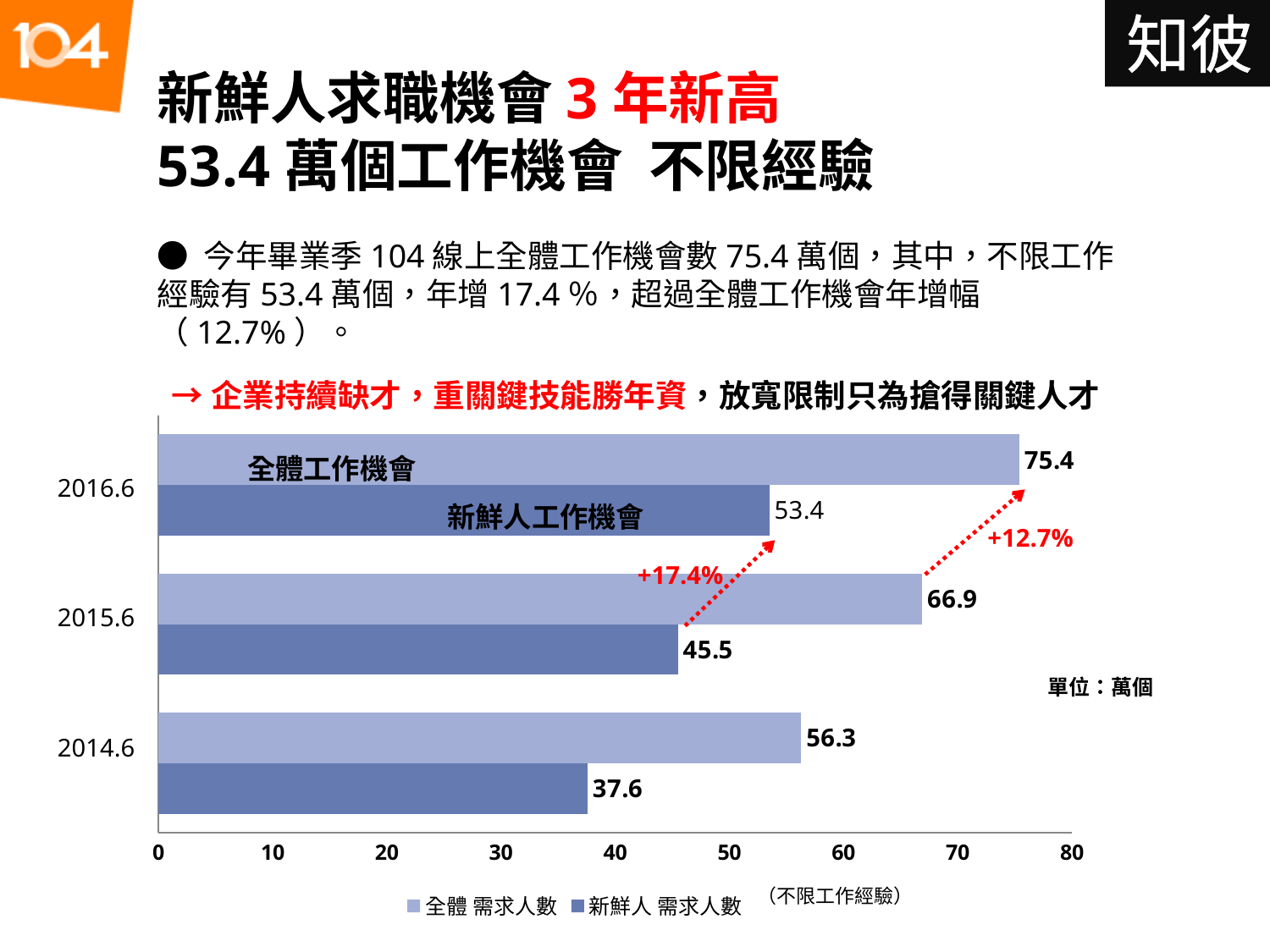
What is the value of 全體 需求人數 for 2016.6? 75.4 What kind of chart is shown on the slide? bar chart Which is larger: 新鮮人 需求人數 in 2016.6 or 全體 需求人數 in 2014.6? 全體 需求人數 in 2014.6 What is the value of 新鮮人 需求人數 for 2014.6? 37.6 How many years are shown on the chart? 3 Which year has the lowest value for 新鮮人 需求人數? 2014.6 What is the value of 新鮮人 需求人數 for 2015.6? 45.5 What unit is stated for the chart values? 萬個 What is the difference between 全體 需求人數 in 2015.6 and 2014.6? 10.6 How many series does the legend list? 2 What is the difference between 全體 需求人數 and 新鮮人 需求人數 in 2016.6? 22.0 Which year has the highest value for 全體 需求人數? 2016.6